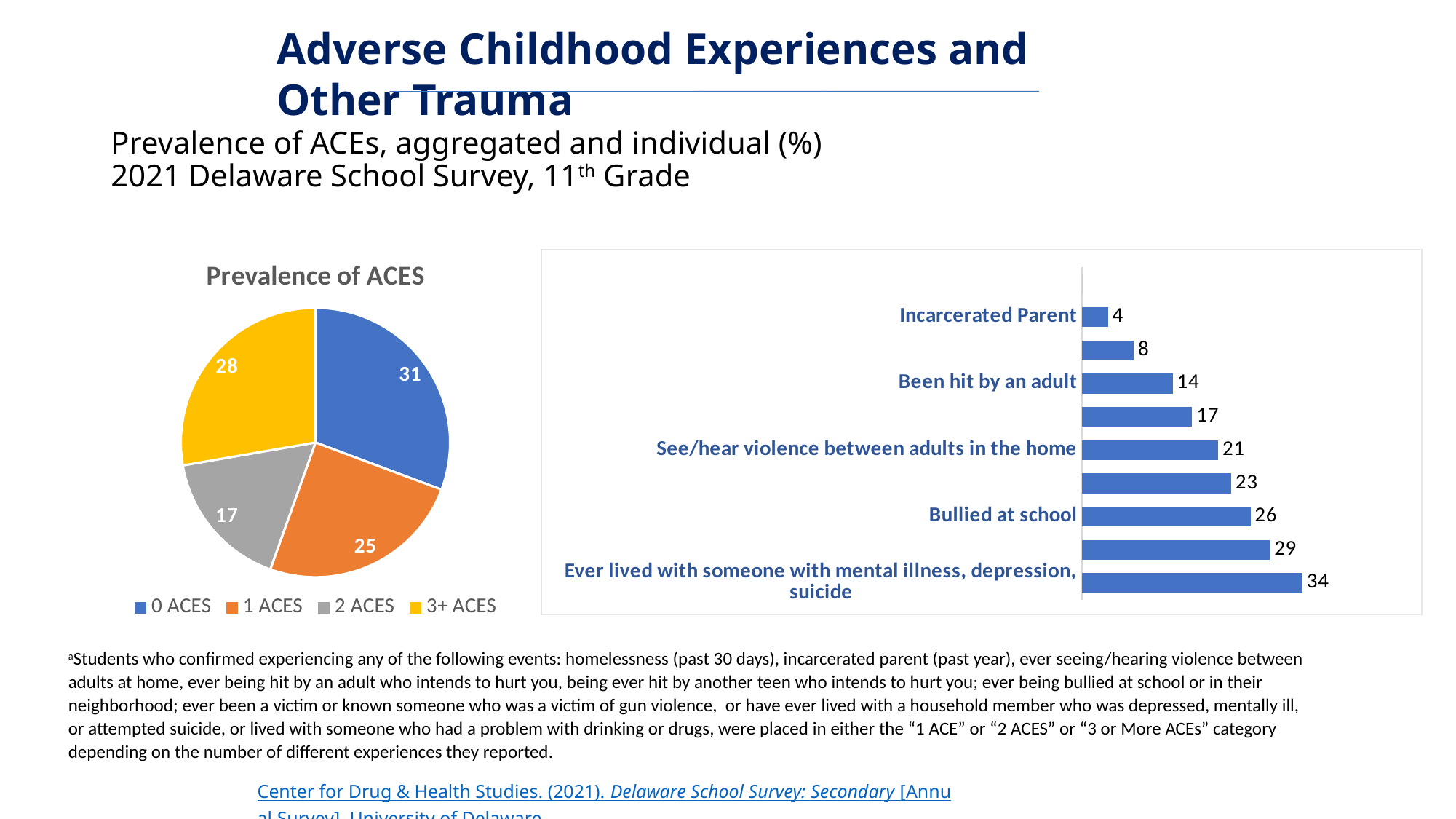
In the bar chart on the right, what is the difference between the values for 'See/hear violence between adults in the home' and 'Been hit by an adult'? 7 In the bar chart on the right, which labeled category has the highest value? Ever lived with someone with mental illness, depression, suicide In the bar chart on the right, what is the value for 'Bullied at school'? 26 In the pie chart titled 'Prevalence of ACES', what is the value for 2 ACES? 17 What kind of chart is the chart on the right side of the slide? Bar chart In the pie chart titled 'Prevalence of ACES', what is the difference between the values for 3+ ACES and 1 ACES? 3 In the bar chart on the right, what is the value for 'Incarcerated Parent'? 4 In the pie chart titled 'Prevalence of ACES', what is the value for 0 ACES? 31 In the pie chart titled 'Prevalence of ACES', how many categories does the legend list? 4 In the pie chart titled 'Prevalence of ACES', what colour is the 3+ ACES slice? Yellow In the pie chart titled 'Prevalence of ACES', which category has the largest slice? 0 ACES In the pie chart titled 'Prevalence of ACES', which category has the smallest slice? 2 ACES